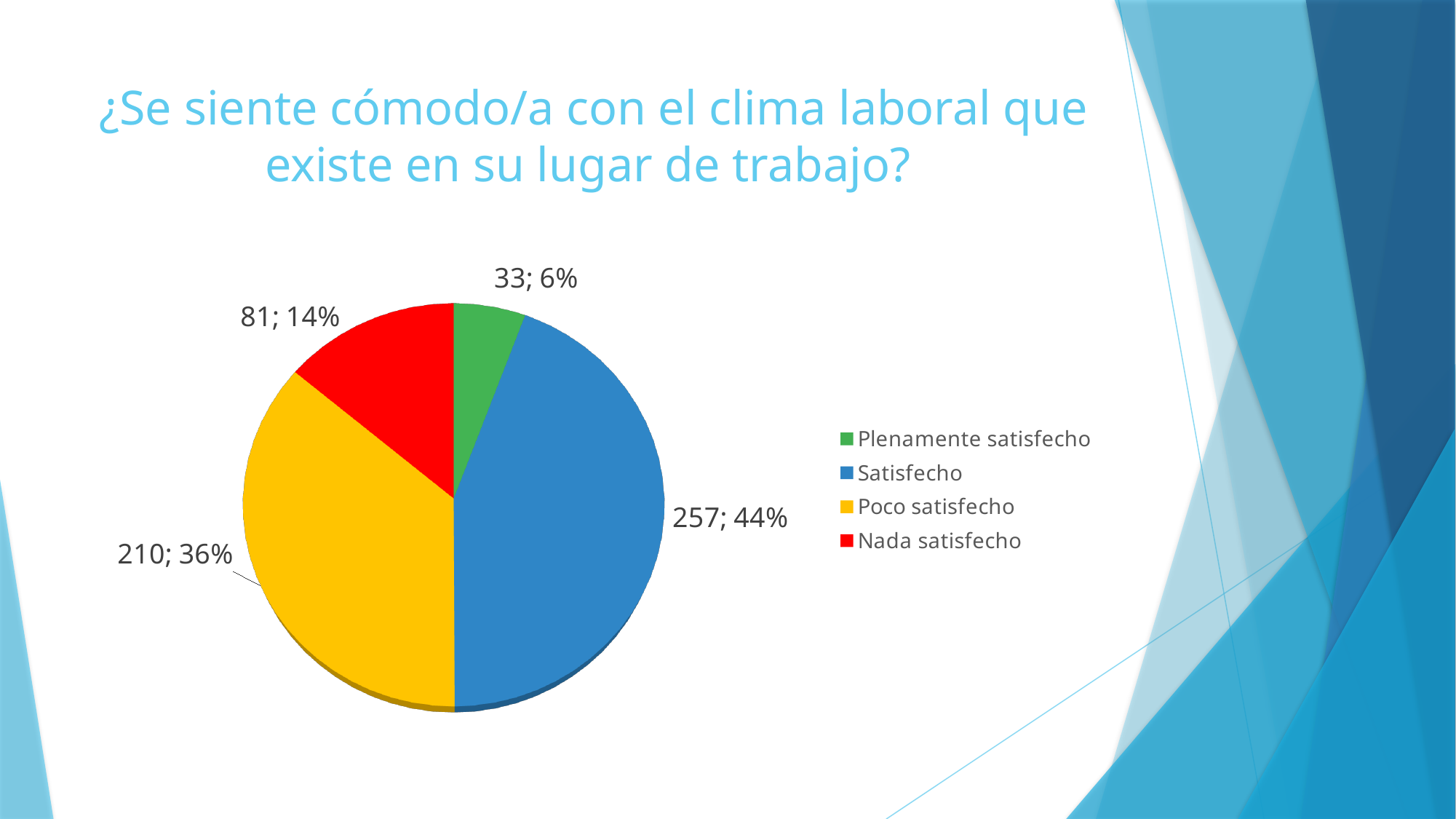
Which category has the largest slice? Satisfecho How many respondents answered "Plenamente satisfecho"? 33 Which is larger, the count for "Nada satisfecho" or for "Plenamente satisfecho"? Nada satisfecho How many respondents answered "Satisfecho"? 257 What is the total number of respondents across all slices? 581 How many categories does the pie chart have? 4 What percentage of the pie does "Poco satisfecho" represent? 36% Which category has the smallest slice? Plenamente satisfecho What colour is the "Poco satisfecho" slice? yellow What is the difference in count between "Satisfecho" and "Poco satisfecho"? 47 What kind of chart is shown on the slide? pie chart What percentage share does "Nada satisfecho" have? 14%